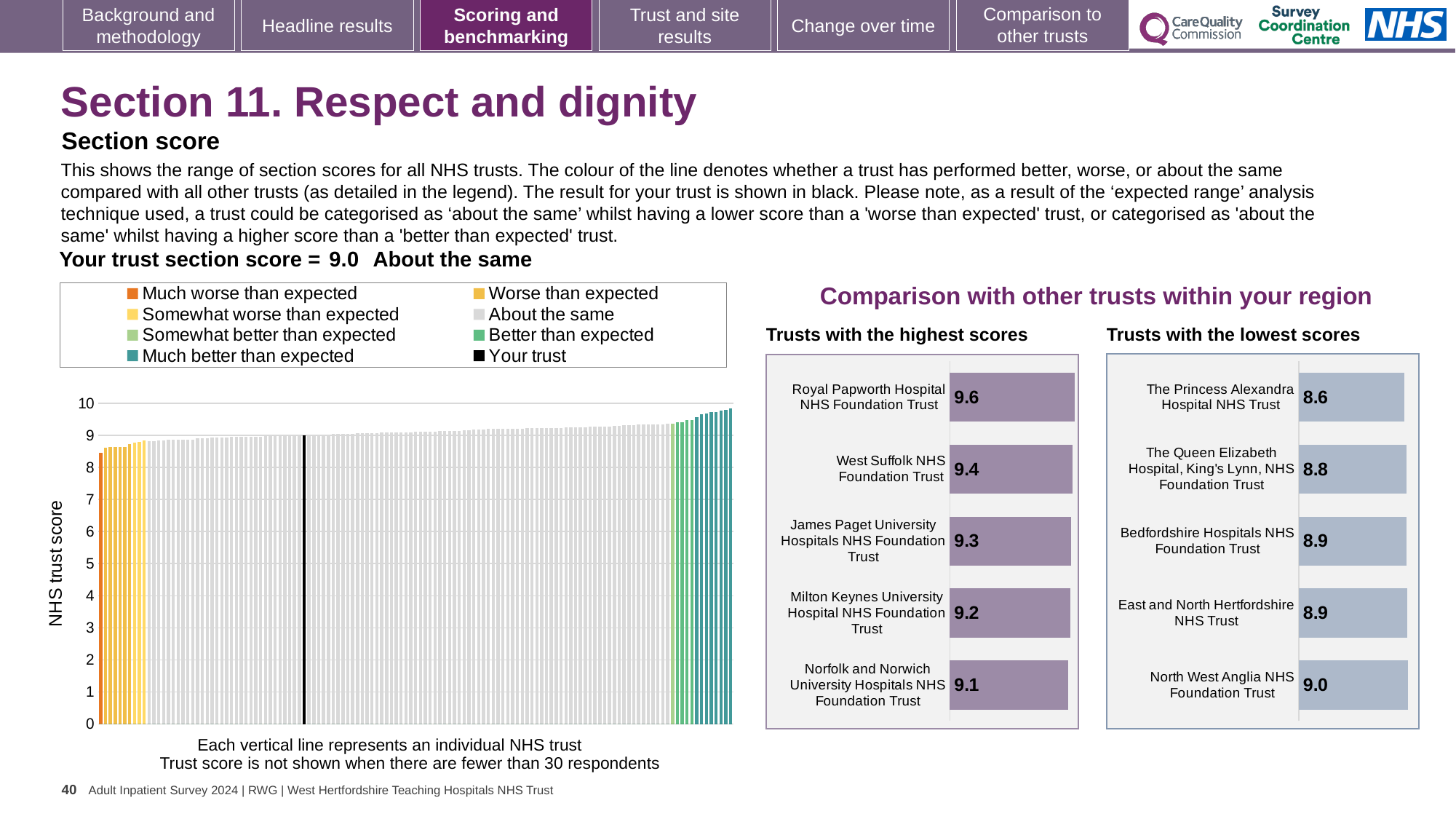
How many entries does the legend of the main NHS trust score chart on the left list? 8 In the 'Trusts with the highest scores' chart, what is the score for Norfolk and Norwich University Hospitals NHS Foundation Trust? 9.1 In the 'Trusts with the highest scores' chart, which trust has the lowest score? Norfolk and Norwich University Hospitals NHS Foundation Trust In the 'Trusts with the lowest scores' chart, which has the larger score: The Queen Elizabeth Hospital, King's Lynn, NHS Foundation Trust or Bedfordshire Hospitals NHS Foundation Trust? Bedfordshire Hospitals NHS Foundation Trust In the 'Trusts with the highest scores' chart, what is the difference between the scores of Royal Papworth Hospital NHS Foundation Trust and West Suffolk NHS Foundation Trust? 0.2 In the 'Trusts with the lowest scores' chart, which trust has the highest score? North West Anglia NHS Foundation Trust How many trusts are shown in the 'Trusts with the lowest scores' chart? 5 In the 'Trusts with the highest scores' chart, what is the score for Royal Papworth Hospital NHS Foundation Trust? 9.6 What type of chart is the 'Trusts with the highest scores' chart? Bar chart In the 'Trusts with the lowest scores' chart, what is the score for The Princess Alexandra Hospital NHS Trust? 8.6 In the main NHS trust score chart on the left, is the value of the leftmost (orange) bar greater or less than 9? less In the main NHS trust score chart on the left, what is the section score for your trust (the black bar)? 9.0